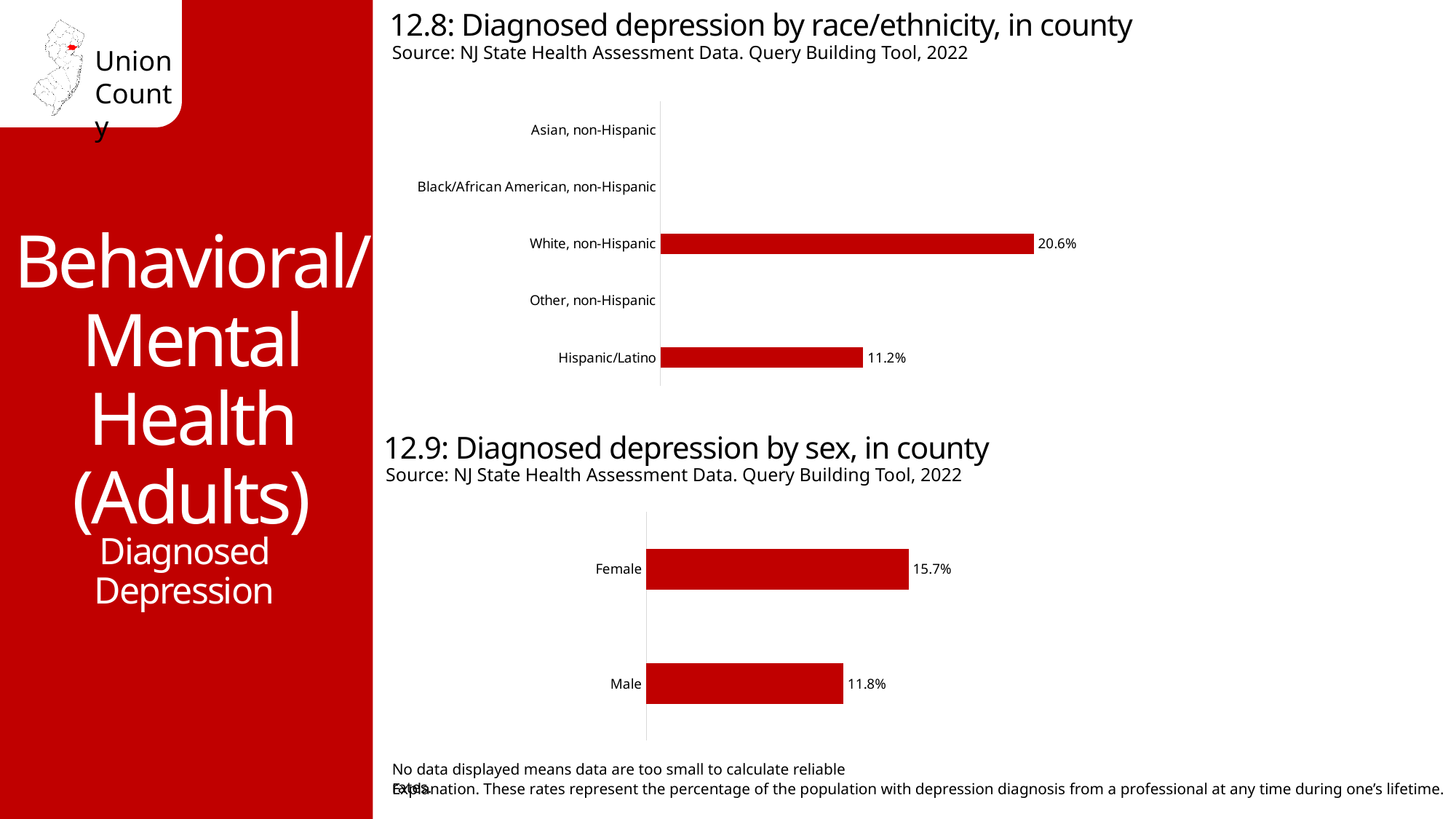
In the chart '12.9: Diagnosed depression by sex, in county', what is the value for Male? 11.8% What kind of chart is '12.8: Diagnosed depression by race/ethnicity, in county'? Bar chart In the chart '12.9: Diagnosed depression by sex, in county', how many categories are shown? 2 In the chart '12.9: Diagnosed depression by sex, in county', which category is larger, Female or Male? Female In the chart '12.8: Diagnosed depression by race/ethnicity, in county', which category has the highest value shown? White, non-Hispanic In the chart '12.8: Diagnosed depression by race/ethnicity, in county', what is the value for Hispanic/Latino? 11.2% In the chart '12.9: Diagnosed depression by sex, in county', what is the value for Female? 15.7% In the chart '12.8: Diagnosed depression by race/ethnicity, in county', how many race/ethnicity categories are listed on the axis? 5 In the chart '12.8: Diagnosed depression by race/ethnicity, in county', what is the value for White, non-Hispanic? 20.6% In the chart '12.8: Diagnosed depression by race/ethnicity, in county', what is the difference between the White, non-Hispanic and Hispanic/Latino values? 9.4% In the chart '12.9: Diagnosed depression by sex, in county', what is the difference between the Female and Male values? 3.9% In the chart '12.8: Diagnosed depression by race/ethnicity, in county', how many categories have a bar with a data value displayed? 2